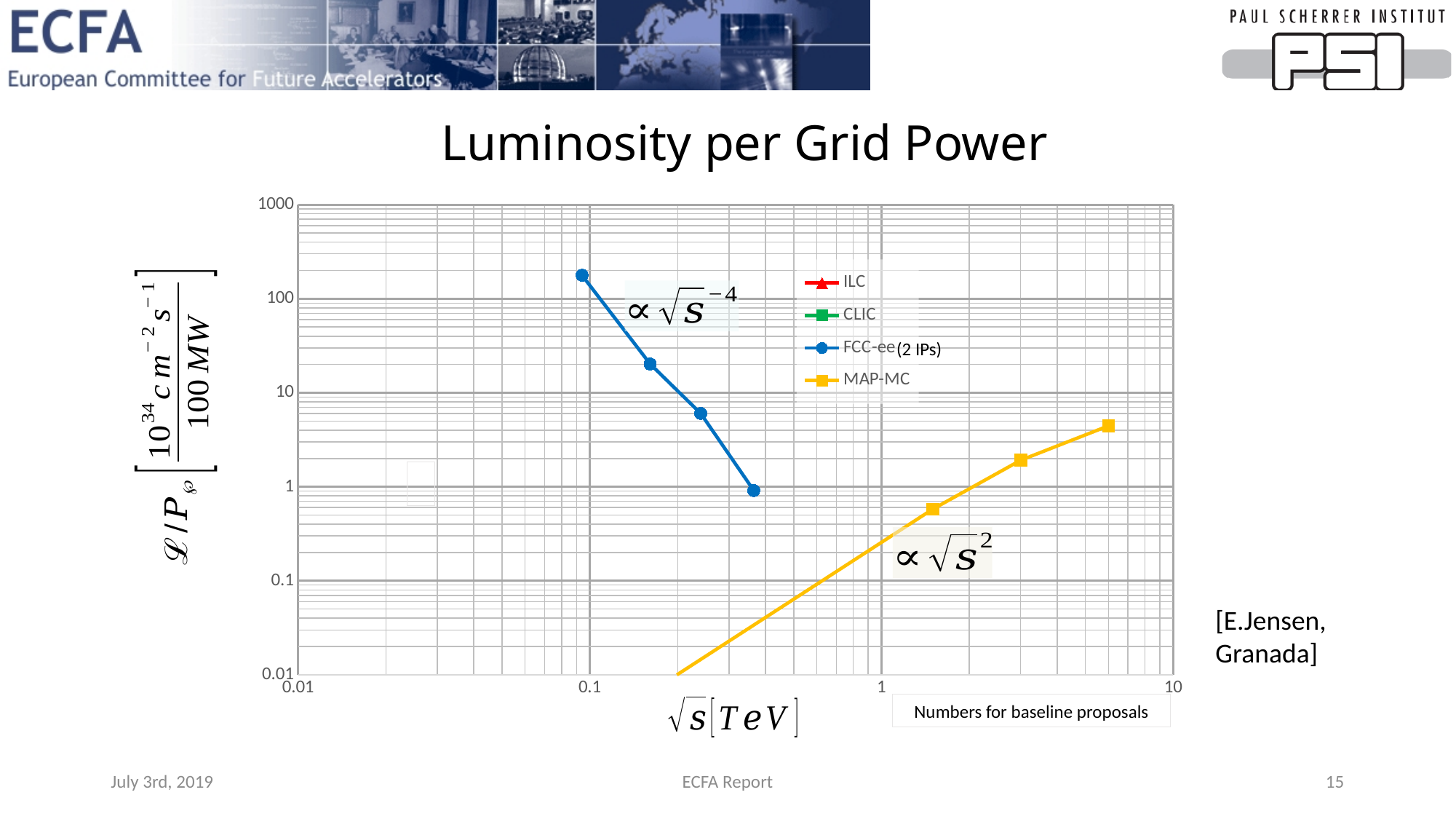
How many data points are marked on the FCC-ee (2 IPs) series? 4 Does the MAP-MC series rise or fall as the x axis increases? rise Which series is drawn in yellow? MAP-MC How many data points are marked on the MAP-MC series? 3 Is the lowest marked value of the MAP-MC series greater or less than 1? less How many series does the legend list? 4 What kind of chart is shown on the slide? line chart Does the FCC-ee (2 IPs) series rise or fall as the x axis increases? fall Is the highest value of the FCC-ee (2 IPs) series greater or less than 100? greater Is the highest value of the MAP-MC series greater or less than 10? less What is the title of the chart? Luminosity per Grid Power Which series reaches the highest value on the chart, FCC-ee (2 IPs) or MAP-MC? FCC-ee (2 IPs)